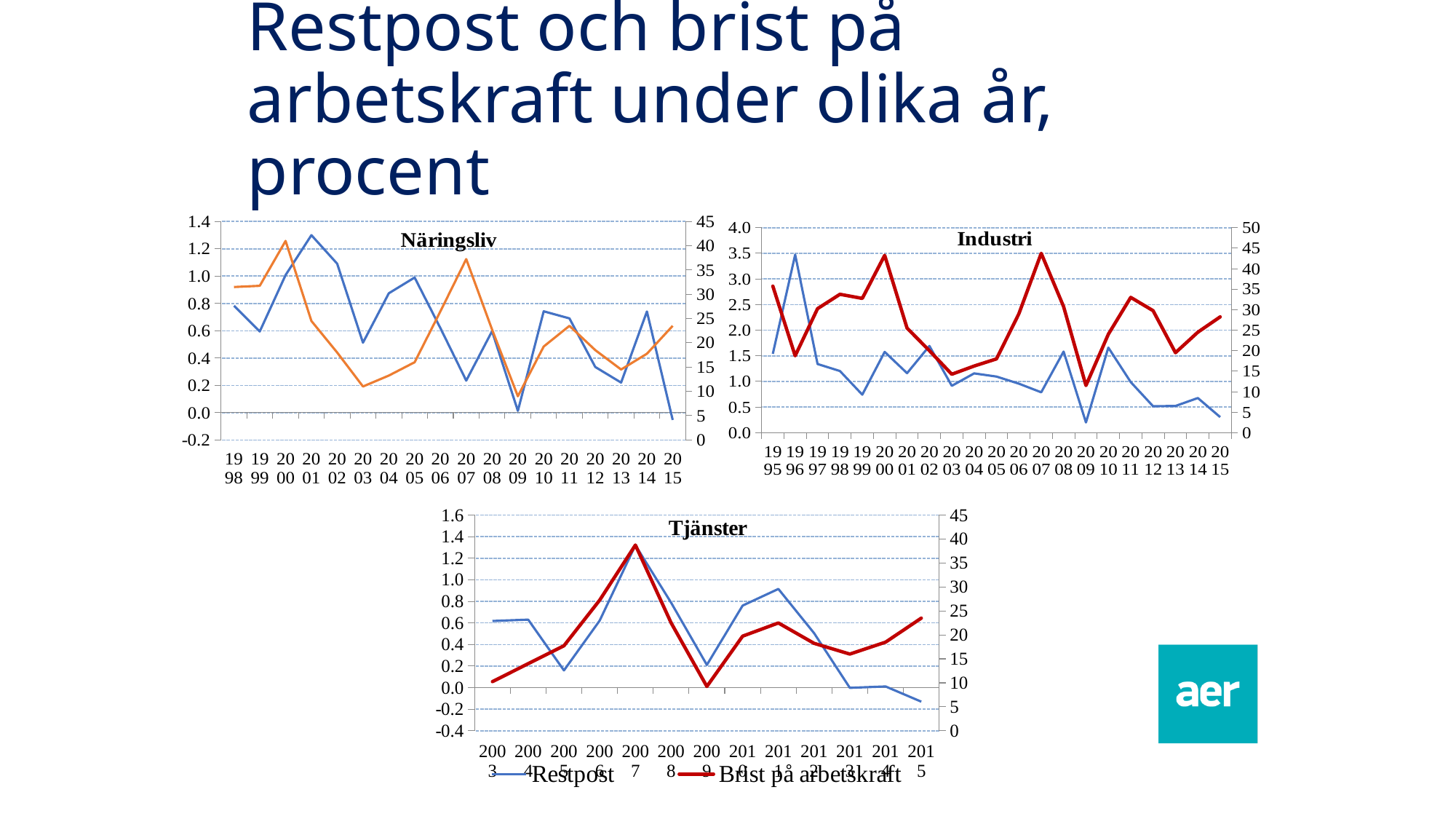
Which colour is used for the Restpost series? blue In the Tjänster chart, is the value of Restpost in 2015 greater or less than 0.0? less What kind of chart is the Näringsliv chart? line chart In the Industri chart, how many years are shown on the x axis? 21 In the Näringsliv chart, in which year is Restpost highest? 2001 In the Industri chart, in which year is Restpost highest? 1996 How many series does the legend at the bottom of the slide list? 2 In the Tjänster chart, which is larger, Restpost in 2007 or Restpost in 2009? 2007 In the Industri chart, is the value of Brist på arbetskraft in 2007 greater or less than 40? greater In the Tjänster chart, in which year is Brist på arbetskraft highest? 2007 In the Tjänster chart, does Restpost rise or fall from 2011 to 2015? fall In the Tjänster chart, how many years are shown on the x axis? 13